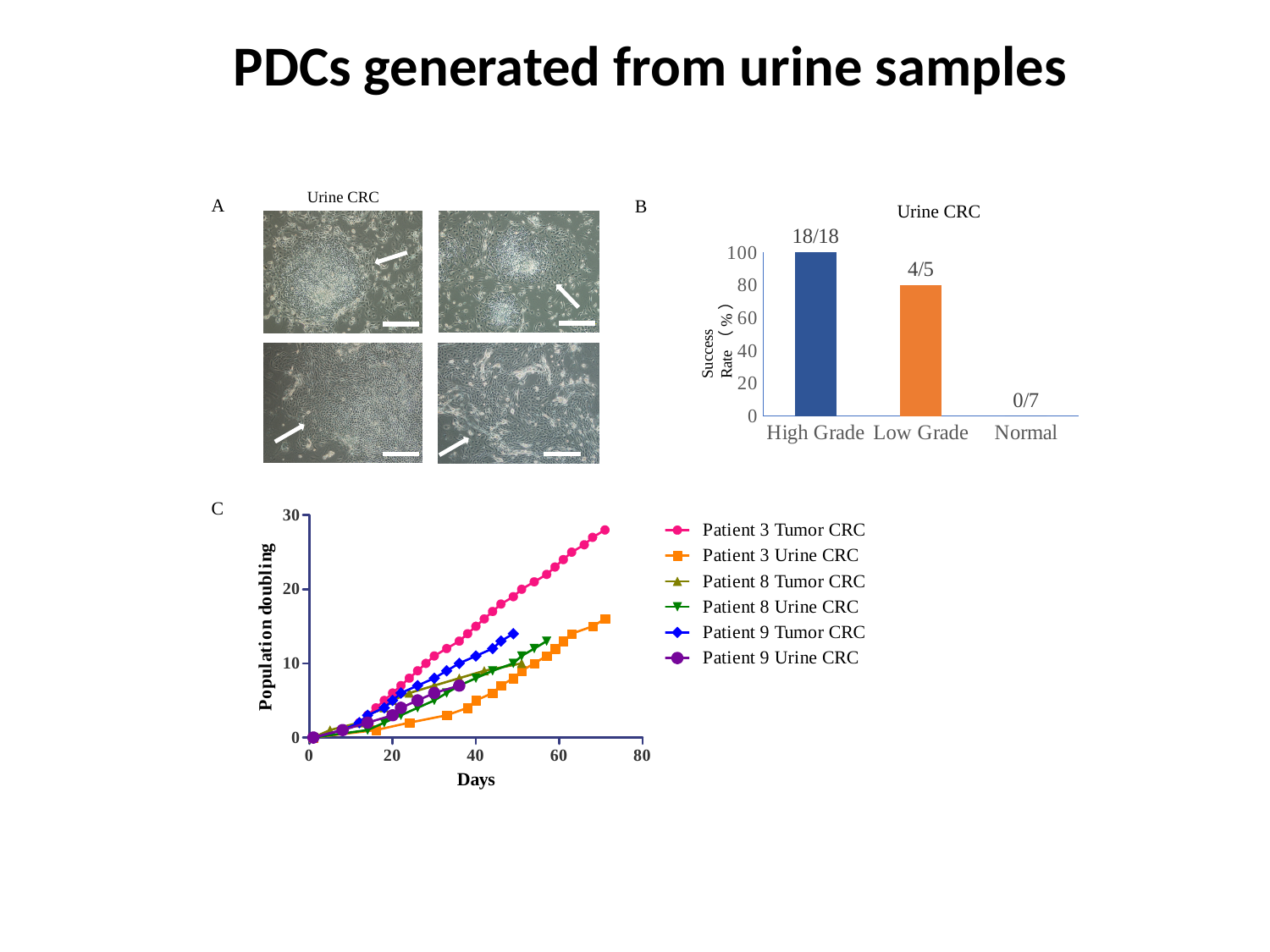
In the bar chart titled Urine CRC, what is the data label shown above the High Grade bar? 18/18 In the Population doubling chart (panel C), how many series does the legend list? 6 In the bar chart titled Urine CRC, what is the data label shown for the Normal category? 0/7 In the bar chart titled Urine CRC, which category has the highest success rate? High Grade What kind of chart is panel C, the Population doubling versus Days chart? line chart In the Population doubling chart (panel C), which series reaches the highest population doubling? Patient 3 Tumor CRC In the bar chart titled Urine CRC, which category has the lowest success rate? Normal In the bar chart titled Urine CRC, is the success rate for Low Grade greater or less than 60? greater In the Population doubling chart (panel C), do the values for Patient 3 Tumor CRC rise or fall as Days increase? rise In the bar chart titled Urine CRC, how many categories are shown on the x axis? 3 In the bar chart titled Urine CRC, what success rate (%) does the High Grade bar reach on the axis? 100 In the bar chart titled Urine CRC, what is the data label shown above the Low Grade bar? 4/5